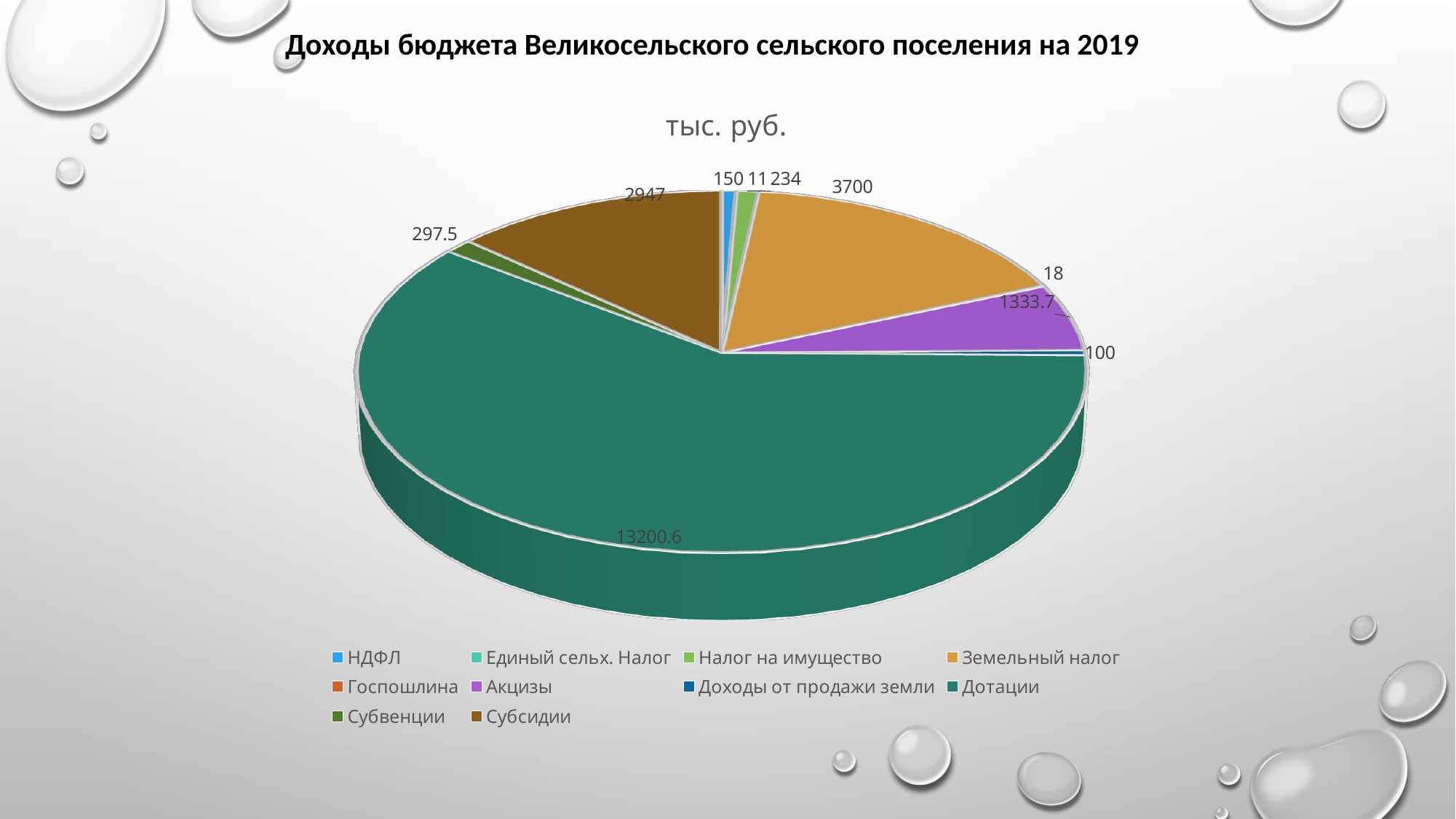
Which category has the largest slice in the pie chart? Дотации What kind of chart is shown on the slide? pie chart What is the title shown above the pie chart? тыс. руб. What is the value for Субвенции in the pie chart? 297.5 What is the value for Субсидии in the pie chart? 2947 What is the difference between the values for Земельный налог and Субсидии? 753 Which is larger, the value for Акцизы or the value for Субсидии? Субсидии Which category has the smallest slice in the pie chart? Единый сельх. Налог What is the value for Дотации in the pie chart? 13200.6 What is the value for Акцизы in the pie chart? 1333.7 How many categories does the legend of the pie chart list? 10 What is the value for Земельный налог in the pie chart? 3700